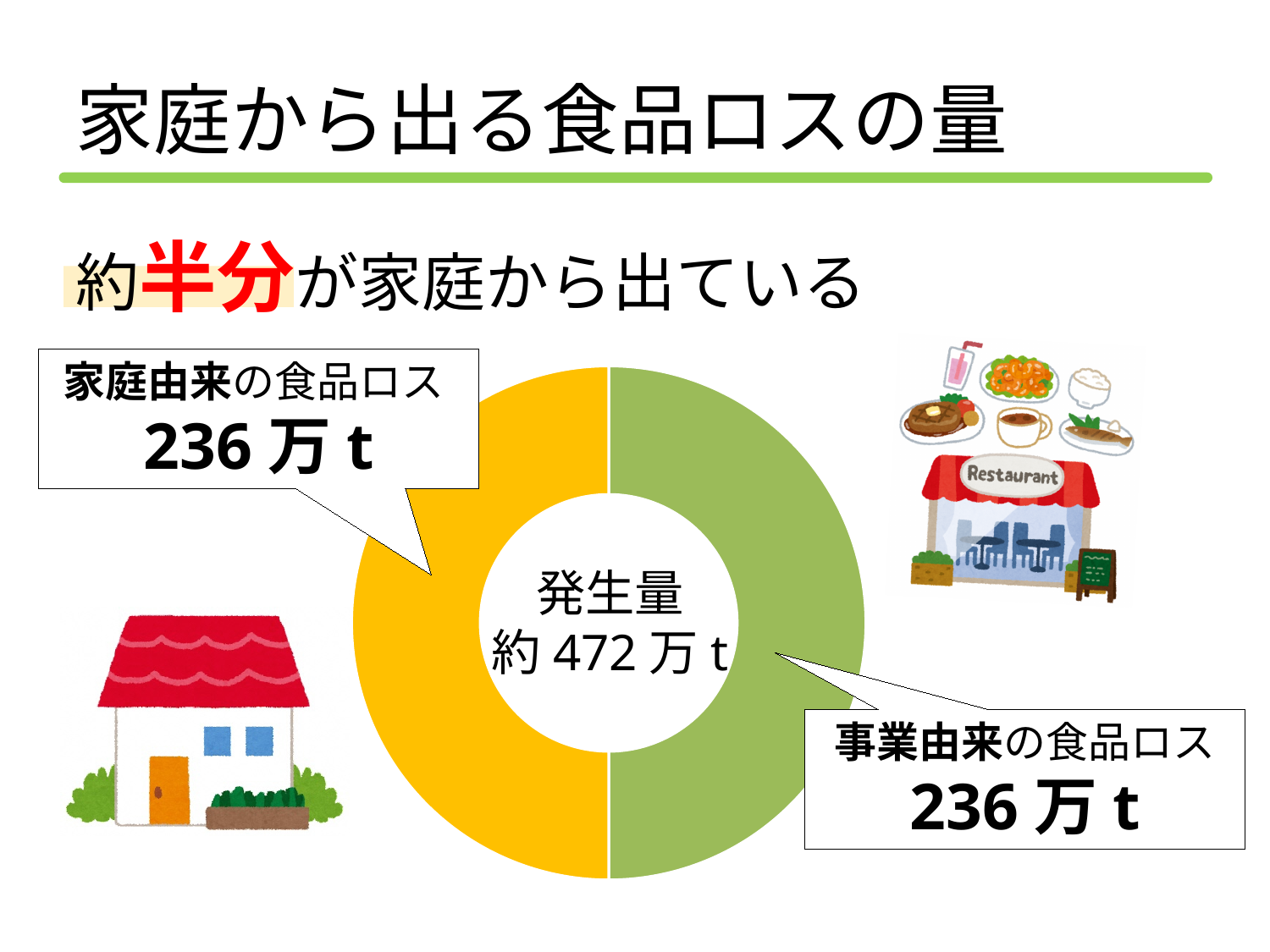
What total amount (発生量) is shown in the centre of the donut chart? 約472万t What is the combined total of 家庭由来の食品ロス and 事業由来の食品ロス? 472万t What is the value for 家庭由来の食品ロス in the donut chart? 236万t What is the difference between the values for 家庭由来の食品ロス and 事業由来の食品ロス? 0 What share of the total does 家庭由来の食品ロス represent? 50% What kind of chart is shown on the slide? Donut (pie) chart What is the value for 事業由来の食品ロス in the donut chart? 236万t Which colour represents 家庭由来の食品ロス in the donut chart? Yellow How many slices does the donut chart have? 2 What share of the total does 事業由来の食品ロス represent? 50% What is the title of the slide containing the donut chart? 家庭から出る食品ロスの量